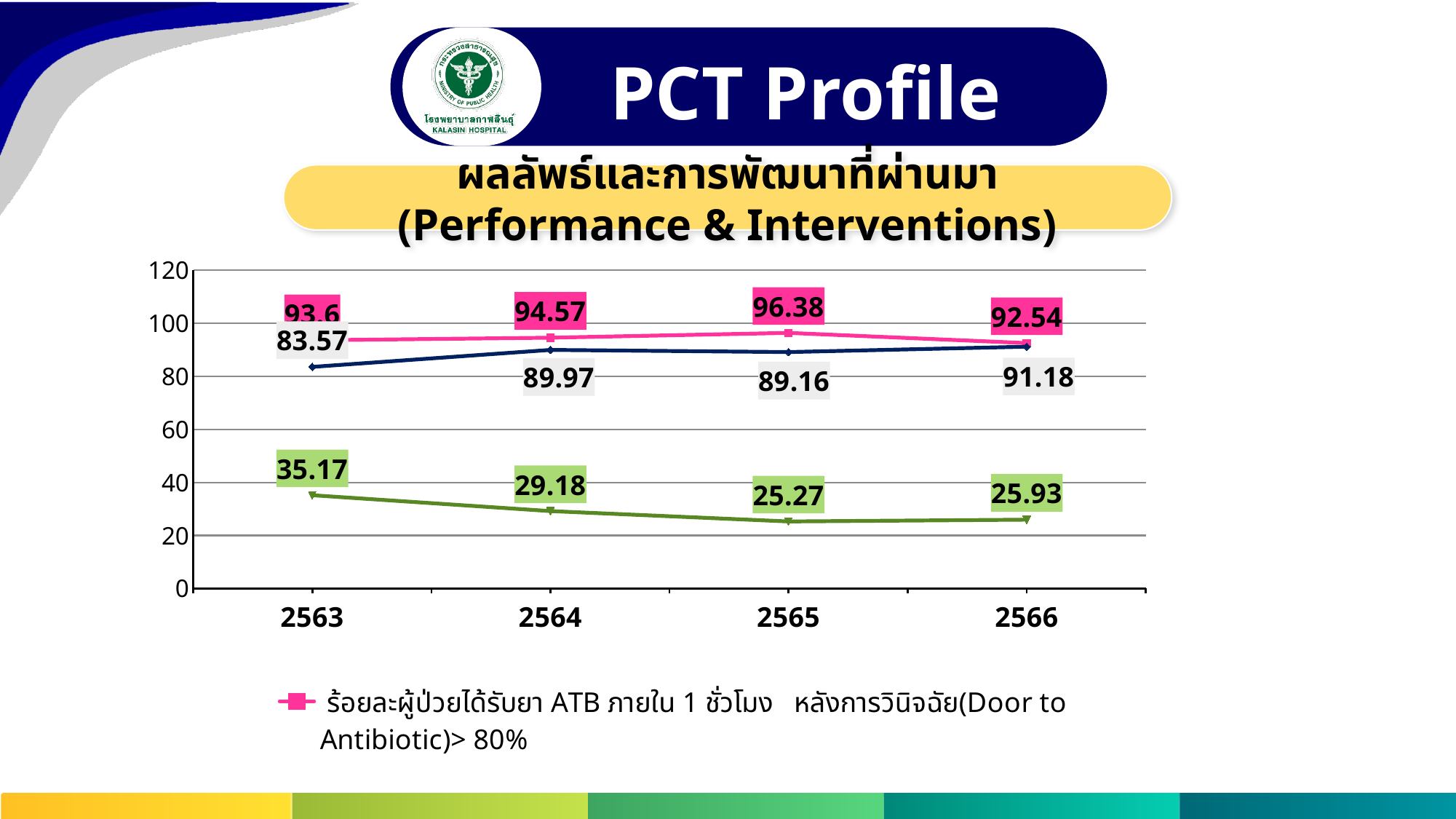
What is the difference between the pink line's value in 2565 and its value in 2566? 3.84 In which year does the green line have its lowest value? 2565 What is the value of the green line in 2564? 29.18 In which year does the pink line (Door to Antibiotic) reach its highest value? 2565 How many years are shown on the x axis of the chart? 4 What is the value of the pink line (Door to Antibiotic) in 2565? 96.38 What is the value of the dark blue line in 2563? 83.57 What is the value of the pink line (Door to Antibiotic) in 2566? 92.54 Which is larger in 2566: the dark blue line's value or the green line's value? the dark blue line (91.18) What type of chart is shown on the slide? line chart Does the green line generally rise or fall from 2563 to 2565? fall